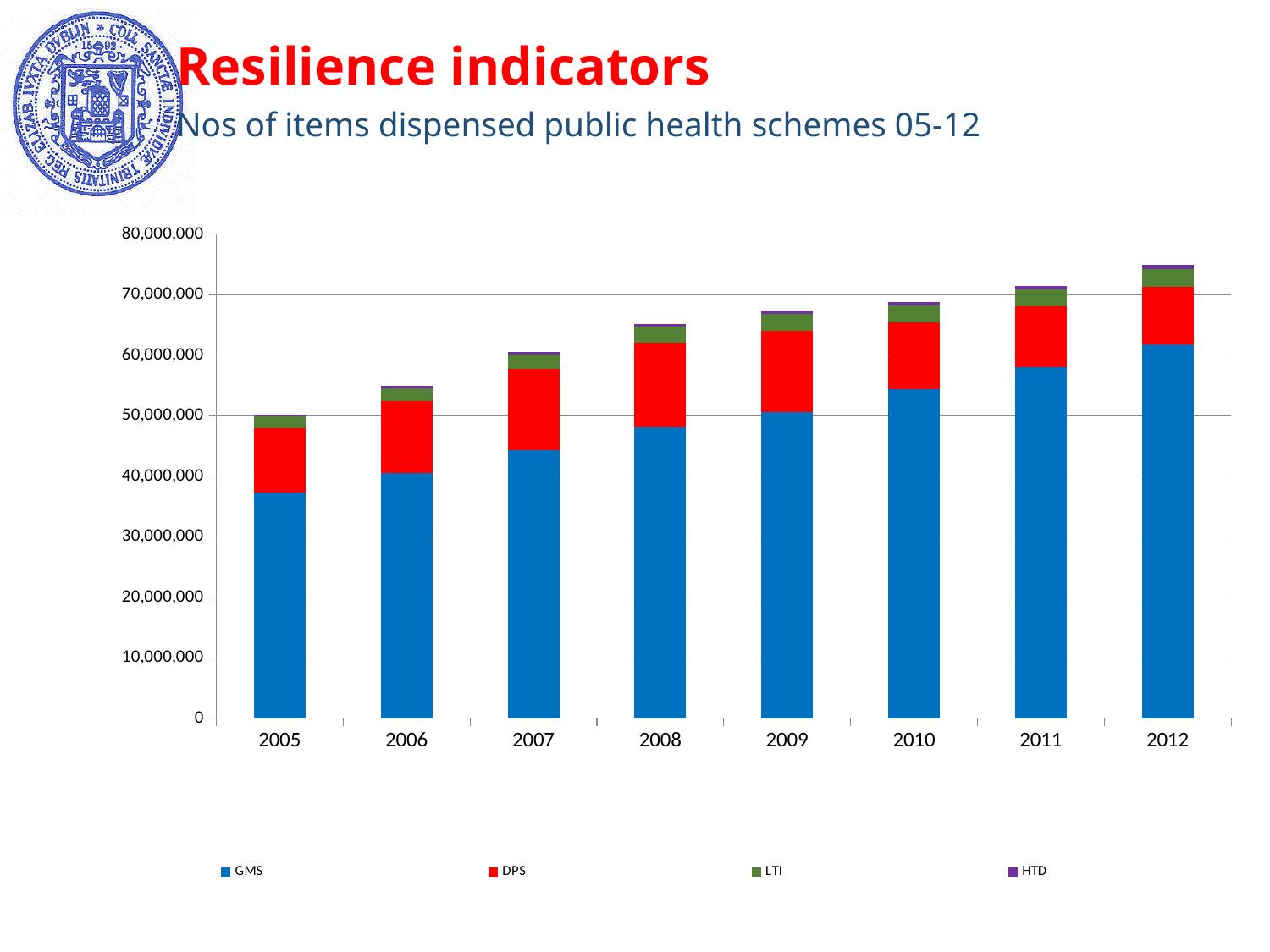
How many years are shown on the x axis of the chart? 8 Which year has the shortest stacked bar? 2005 Do the total bar heights rise or fall from 2005 to 2012? Rise Is the total stacked bar for 2010 greater or less than 70,000,000? less Which year has the tallest stacked bar? 2012 Is the GMS value for 2005 greater or less than 40,000,000? less Is the GMS value for 2012 greater or less than 60,000,000? greater Which series are listed in the legend? GMS, DPS, LTI, HTD What kind of chart is shown on the slide? Stacked bar chart Which is larger, the GMS value for 2012 or the GMS value for 2005? 2012 How many series does the legend list? 4